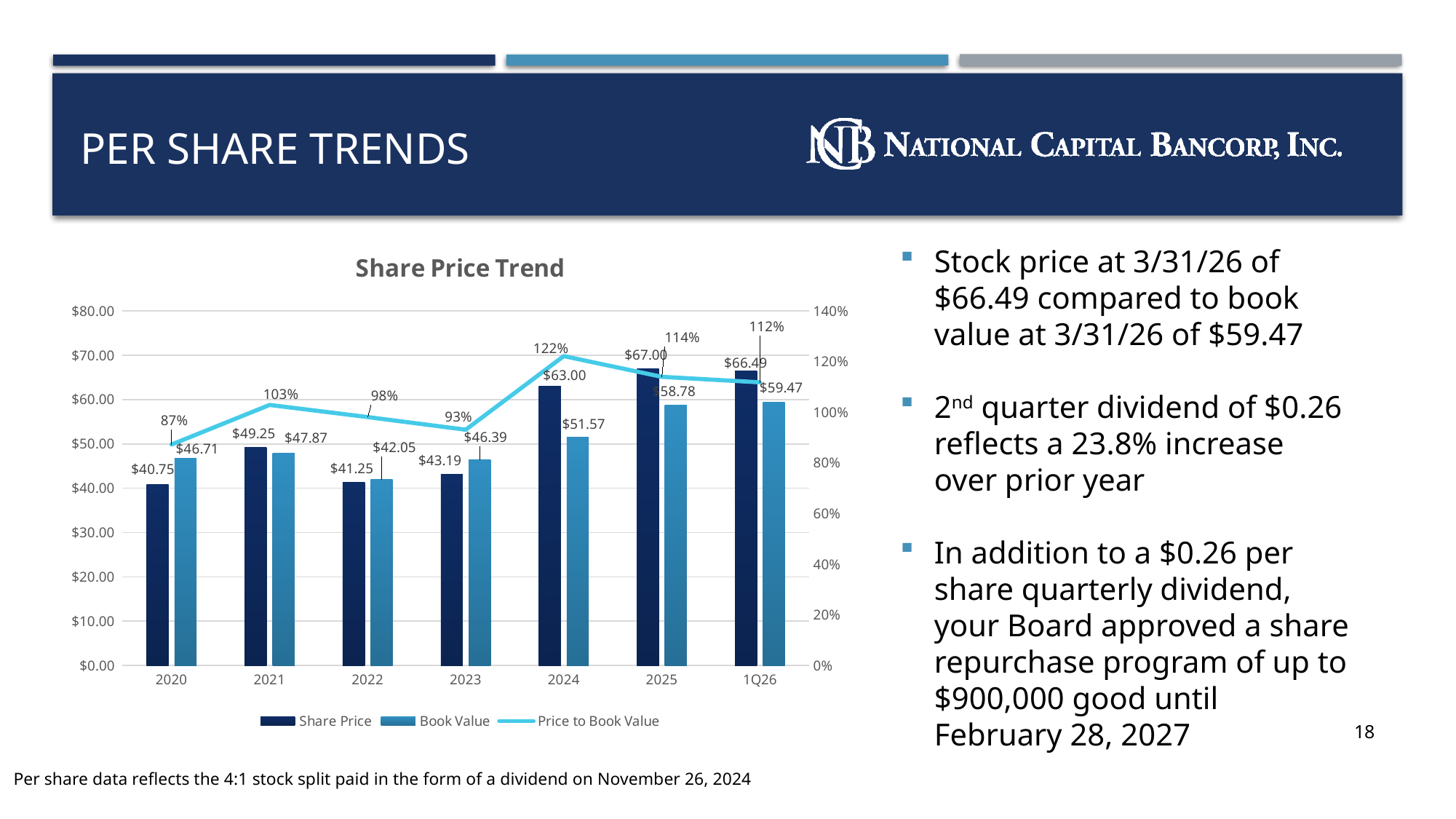
What is the Share Price for 2024? $63.00 Which period has the lowest Price to Book Value? 2020 What is the title of the chart? Share Price Trend What is the Book Value for 2025? $58.78 In 2021, which is larger: the Share Price or the Book Value? Share Price What is the difference between the Share Price in 2025 and the Share Price in 2020? $26.25 How many periods are shown on the x axis of the chart? 7 Which period has the highest Share Price? 2025 What kind of chart is shown on the slide? Bar and line chart How many series does the chart legend list? 3 What is the Price to Book Value for 2024? 122% Does the Book Value rise or fall from 2022 to 1Q26? Rise